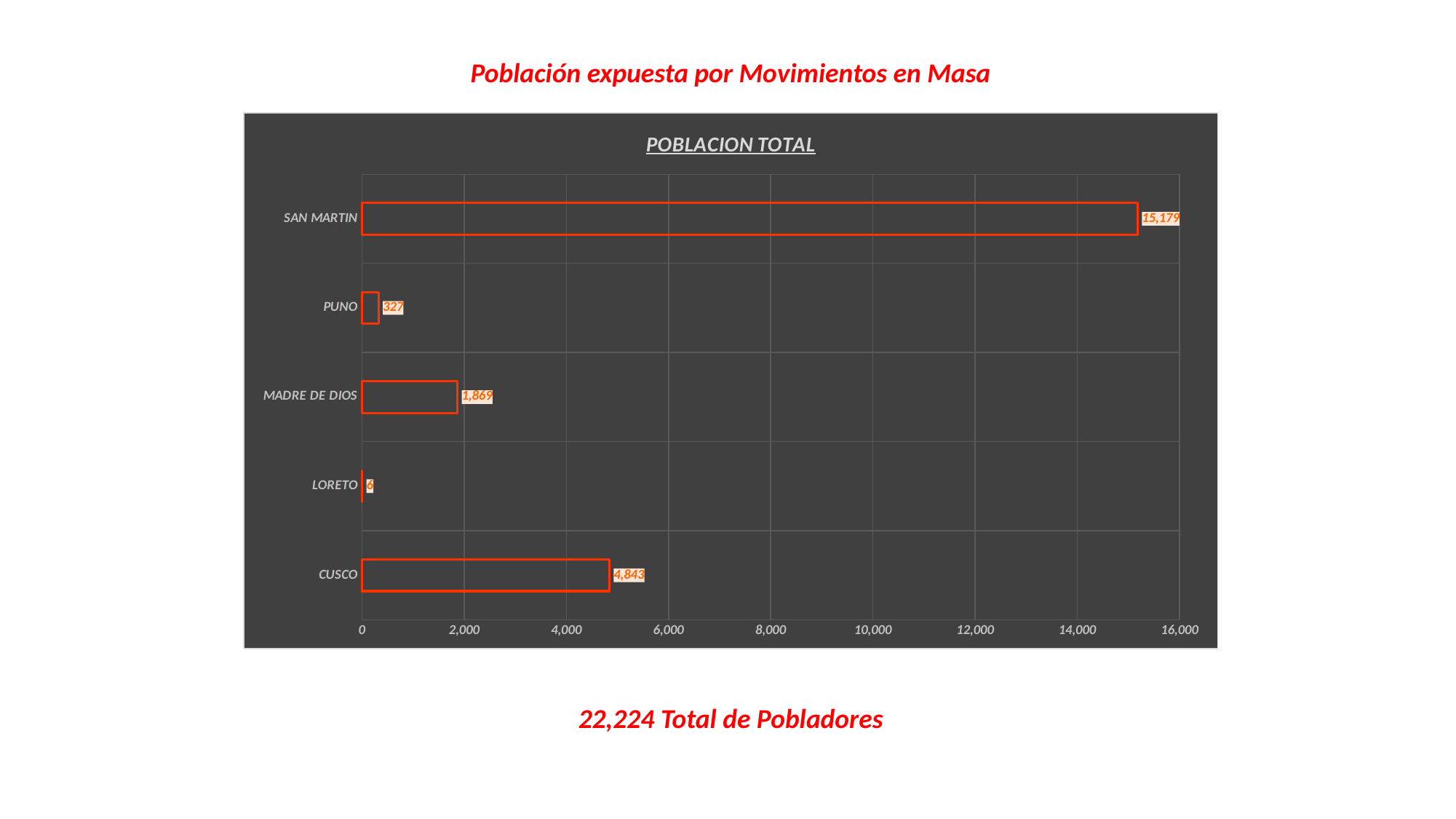
Which category has the highest value? SAN MARTIN How many categories are shown in the chart? 5 What is the difference between the values for SAN MARTIN and CUSCO? 10,336 Which is larger, the value for CUSCO or the value for MADRE DE DIOS? CUSCO What is the value for CUSCO? 4,843 What is the value for MADRE DE DIOS? 1,869 Which category has the lowest value? LORETO What kind of chart is shown? Bar chart What is the value for PUNO? 327 What is the difference between the values for MADRE DE DIOS and PUNO? 1,542 What is the value for SAN MARTIN? 15,179 What is the title of the chart? POBLACION TOTAL